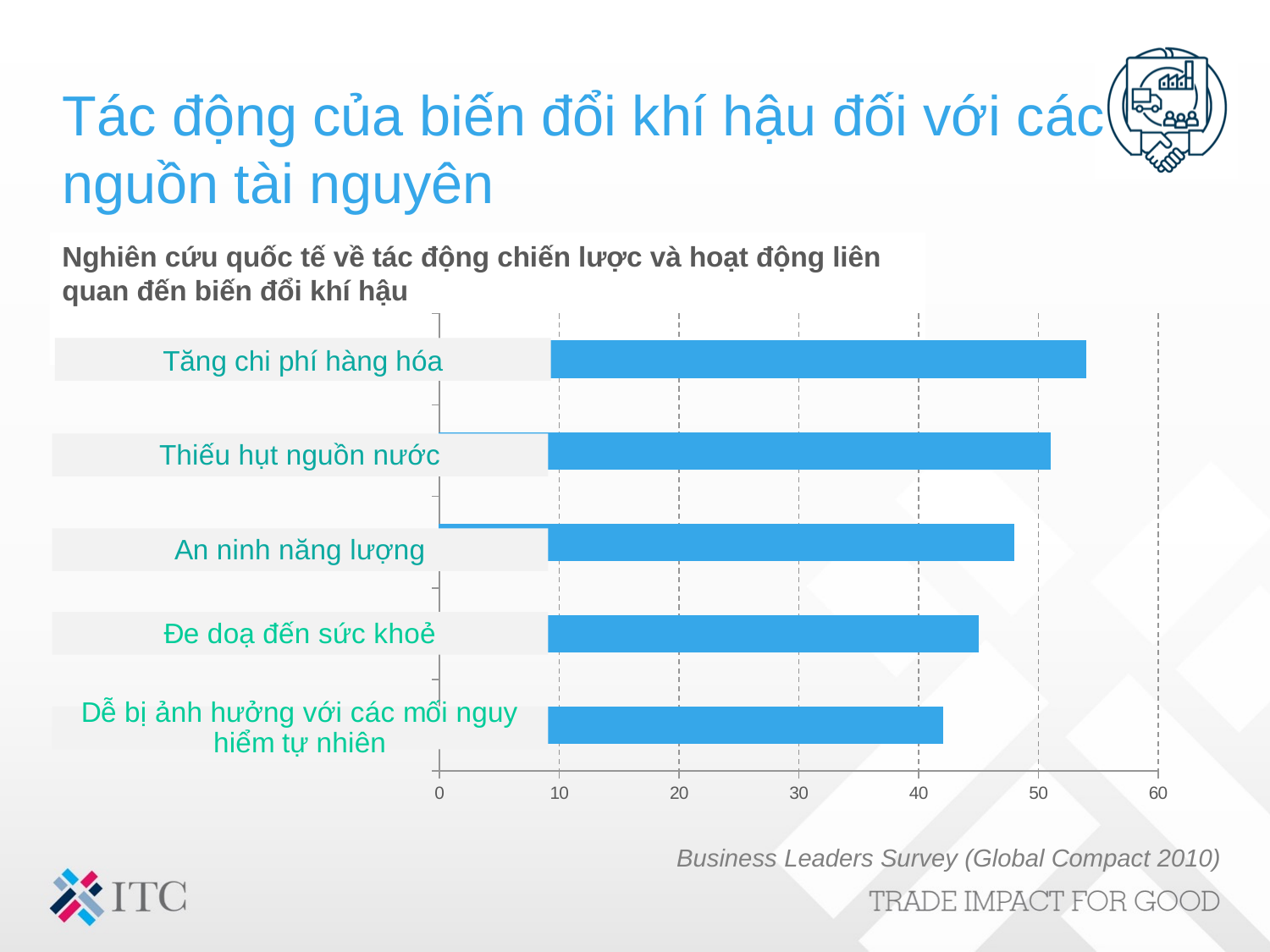
Which category has the lowest value in the chart? Dễ bị ảnh hưởng với các mối nguy hiểm tự nhiên Which is larger: the value for Thiếu hụt nguồn nước or the value for An ninh năng lượng? Thiếu hụt nguồn nước What kind of chart is shown on the slide? bar chart Which category has the highest value in the chart? Tăng chi phí hàng hóa Is the value for An ninh năng lượng greater or less than 50? less Is the value for Dễ bị ảnh hưởng với các mối nguy hiểm tự nhiên greater or less than 50? less Is the value for Thiếu hụt nguồn nước greater or less than 40? greater Which is larger: the value for Đe doạ đến sức khoẻ or the value for Tăng chi phí hàng hóa? Tăng chi phí hàng hóa How many categories are shown in the chart? 5 What is the highest value shown on the horizontal axis of the chart? 60